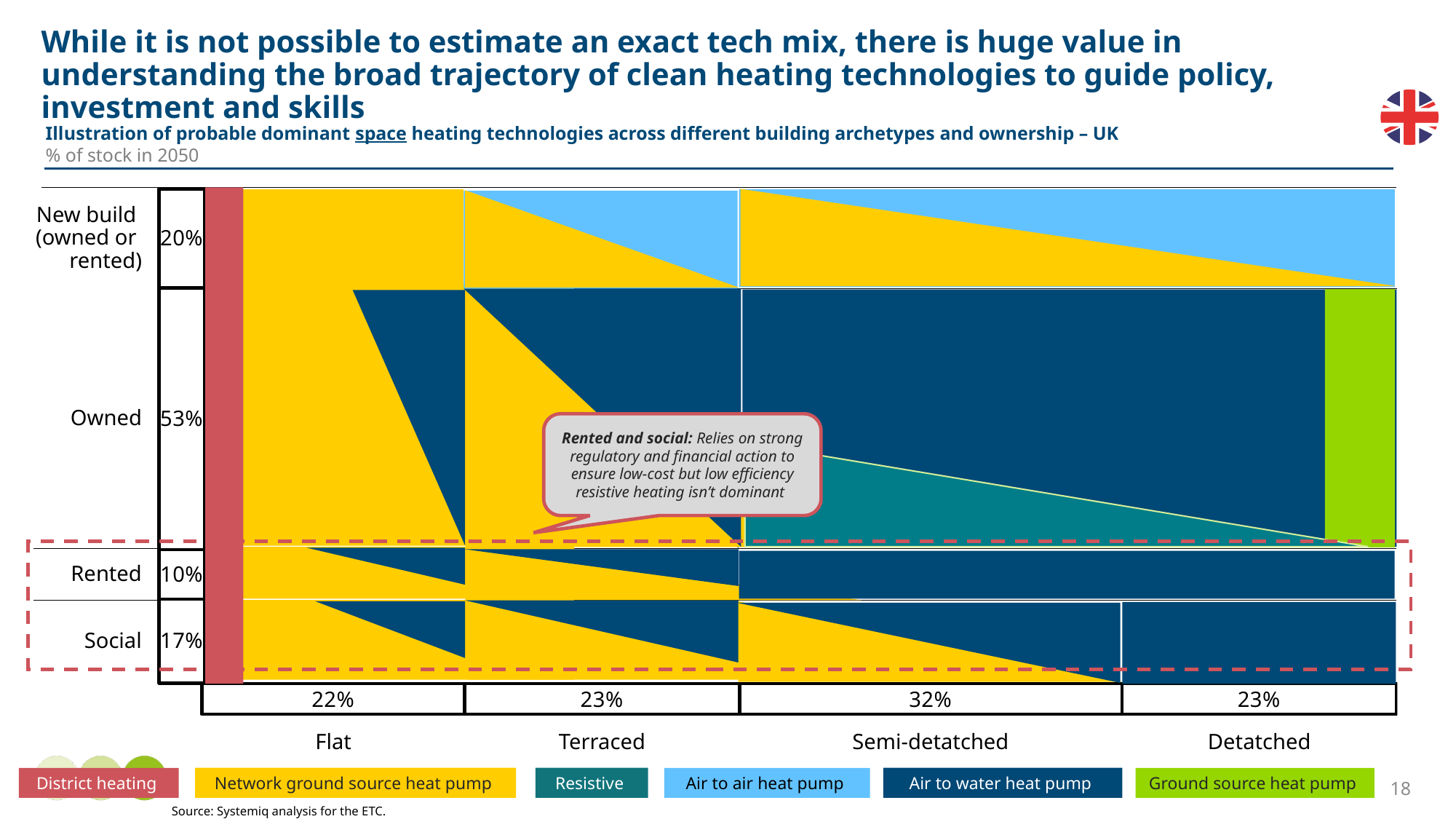
Which has a larger share of stock in 2050, Flat or Semi-detatched? Semi-detatched How many building archetypes are shown along the bottom of the chart? 4 What percentage of stock in 2050 is shown for the Flat building archetype? 22% Which ownership category has the largest share of stock in 2050? Owned Which heating technology is shown in the legend with a light blue colour? Air to air heat pump How many heating technologies does the legend list? 6 What percentage of stock in 2050 is shown for the Semi-detatched building archetype? 32% What is the difference in share of stock between the Owned and New build ownership categories? 33% What percentage of stock in 2050 is shown for the Social ownership category? 17% Which building archetype has the largest share of stock in 2050? Semi-detatched What percentage of stock in 2050 is shown for the Owned ownership category? 53% Which ownership category has the smallest share of stock in 2050? Rented